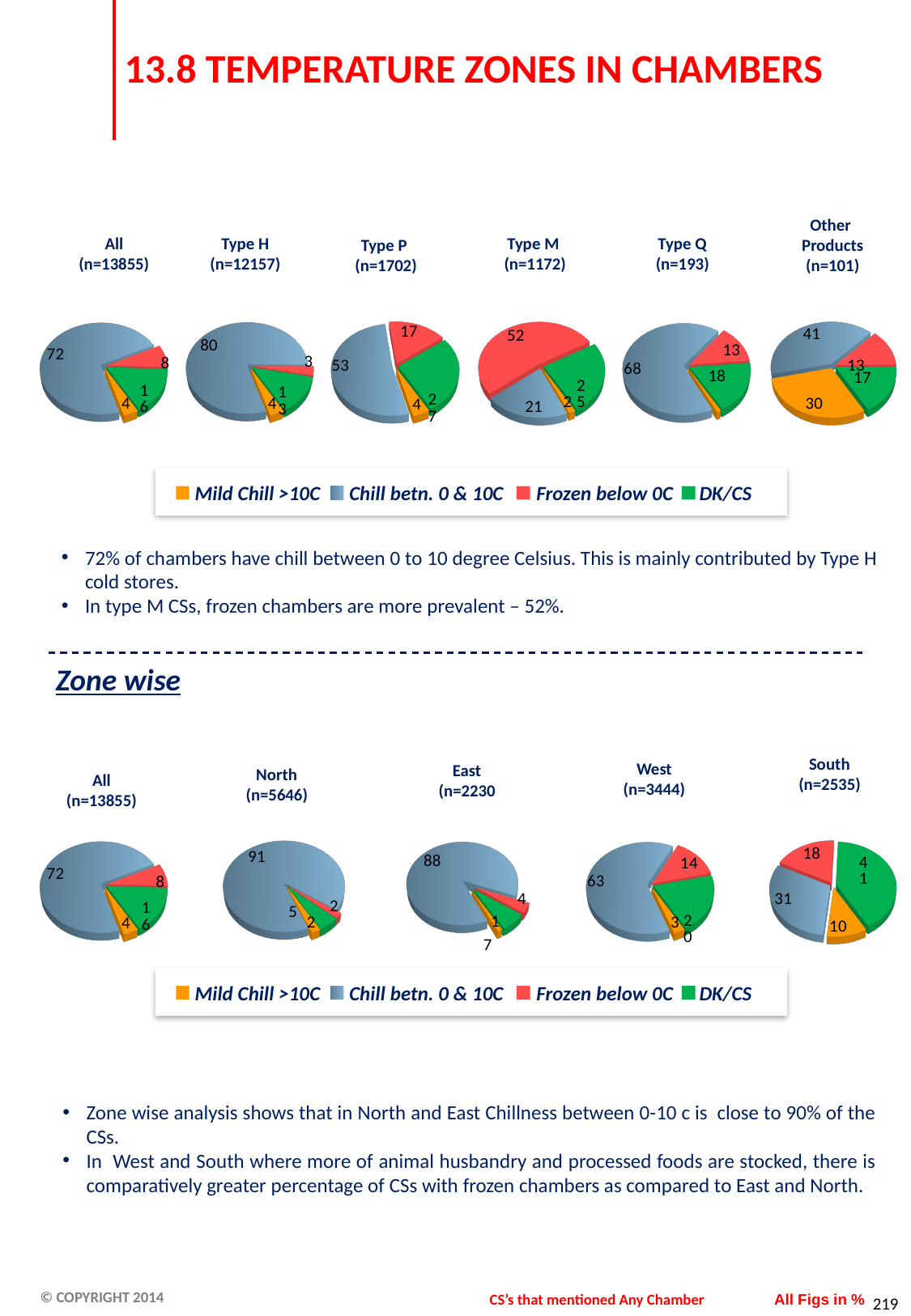
In the Zone wise pie charts, what percentage of West (n=3444) chambers are Frozen below 0C? 14 What kind of chart is used on this slide to show temperature zones in chambers? Pie chart In the top row of pie charts, which cold store type has the highest Chill betn. 0 & 10C share? Type H In the top row of pie charts, what percentage of Type Q (n=193) chambers are Chill betn. 0 & 10C? 68 In the top row of pie charts, what percentage of Type H (n=12157) chambers are Chill betn. 0 & 10C? 80 In the Zone wise pie charts, what is the difference between the Chill betn. 0 & 10C share for North and for West? 28 In the top row of pie charts, what percentage of Type M (n=1172) chambers are Frozen below 0C? 52 In the Zone wise pie charts, what percentage of North (n=5646) chambers are Chill betn. 0 & 10C? 91 How many categories does the legend list for the temperature zone pie charts? 4 In the top row of pie charts, which is larger: the Frozen below 0C share for Type M or for Type P? Type M How many pie charts are shown in the top row (by cold store type)? 6 In the top row of pie charts, what percentage of Other Products (n=101) chambers are Mild Chill >10C? 30